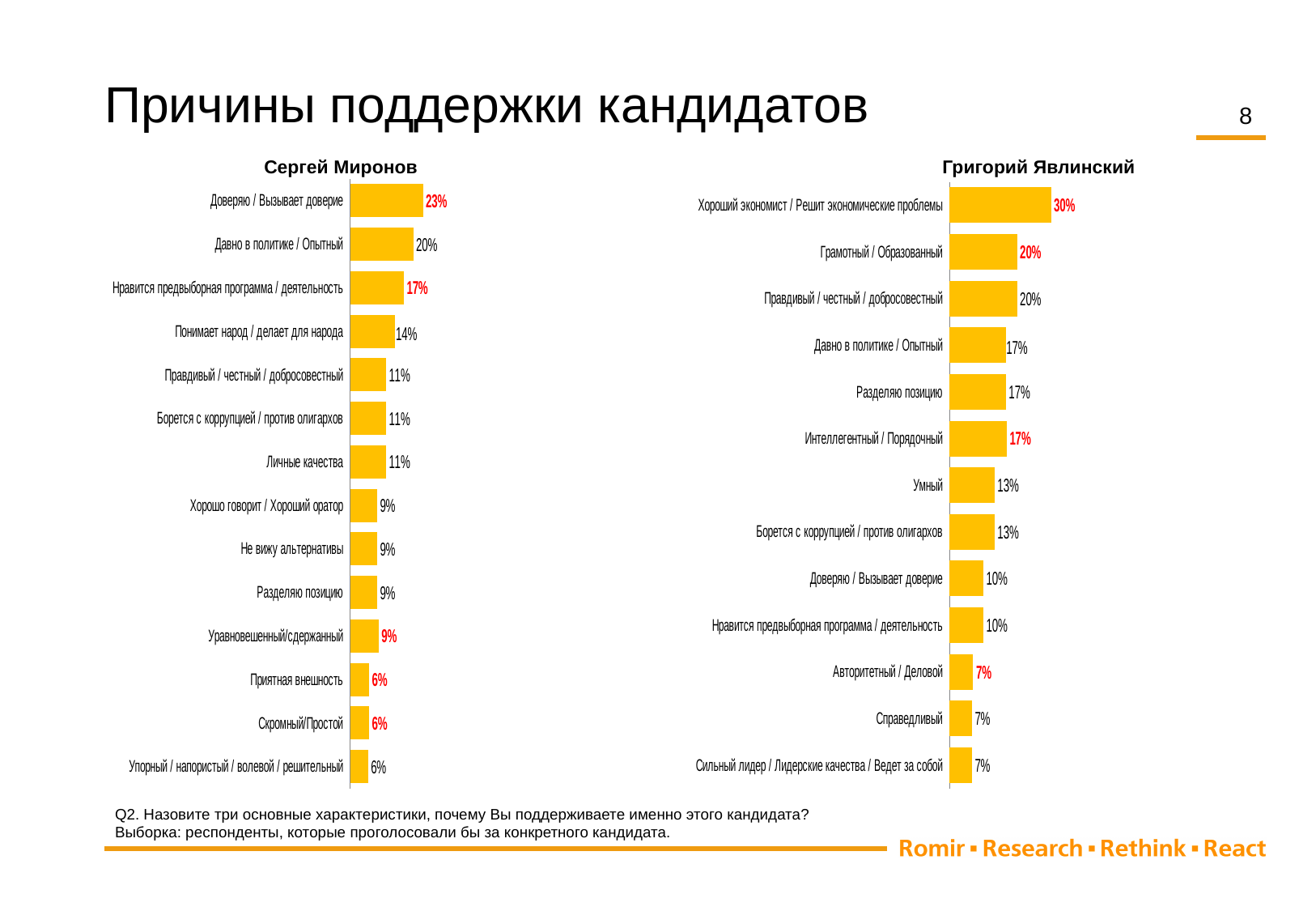
In the "Сергей Миронов" chart, what is the value for "Доверяю / Вызывает доверие"? 23% In the "Григорий Явлинский" chart, what is the difference between "Грамотный / Образованный" and "Умный"? 7% How many categories are shown in the "Сергей Миронов" chart? 14 In the "Сергей Миронов" chart, which is larger: "Нравится предвыборная программа / деятельность" or "Личные качества"? Нравится предвыборная программа / деятельность In the "Сергей Миронов" chart, what is the difference between "Давно в политике / Опытный" and "Понимает народ / делает для народа"? 6% In the "Григорий Явлинский" chart, what is the value for "Хороший экономист / Решит экономические проблемы"? 30% In the "Григорий Явлинский" chart, which is larger: "Давно в политике / Опытный" or "Доверяю / Вызывает доверие"? Давно в политике / Опытный In the "Сергей Миронов" chart, what is the value for "Скромный/Простой"? 6% In the "Григорий Явлинский" chart, which category has the highest value? Хороший экономист / Решит экономические проблемы How many categories are shown in the "Григорий Явлинский" chart? 13 What type of chart is the "Григорий Явлинский" chart? Bar chart In the "Сергей Миронов" chart, which category has the highest value? Доверяю / Вызывает доверие